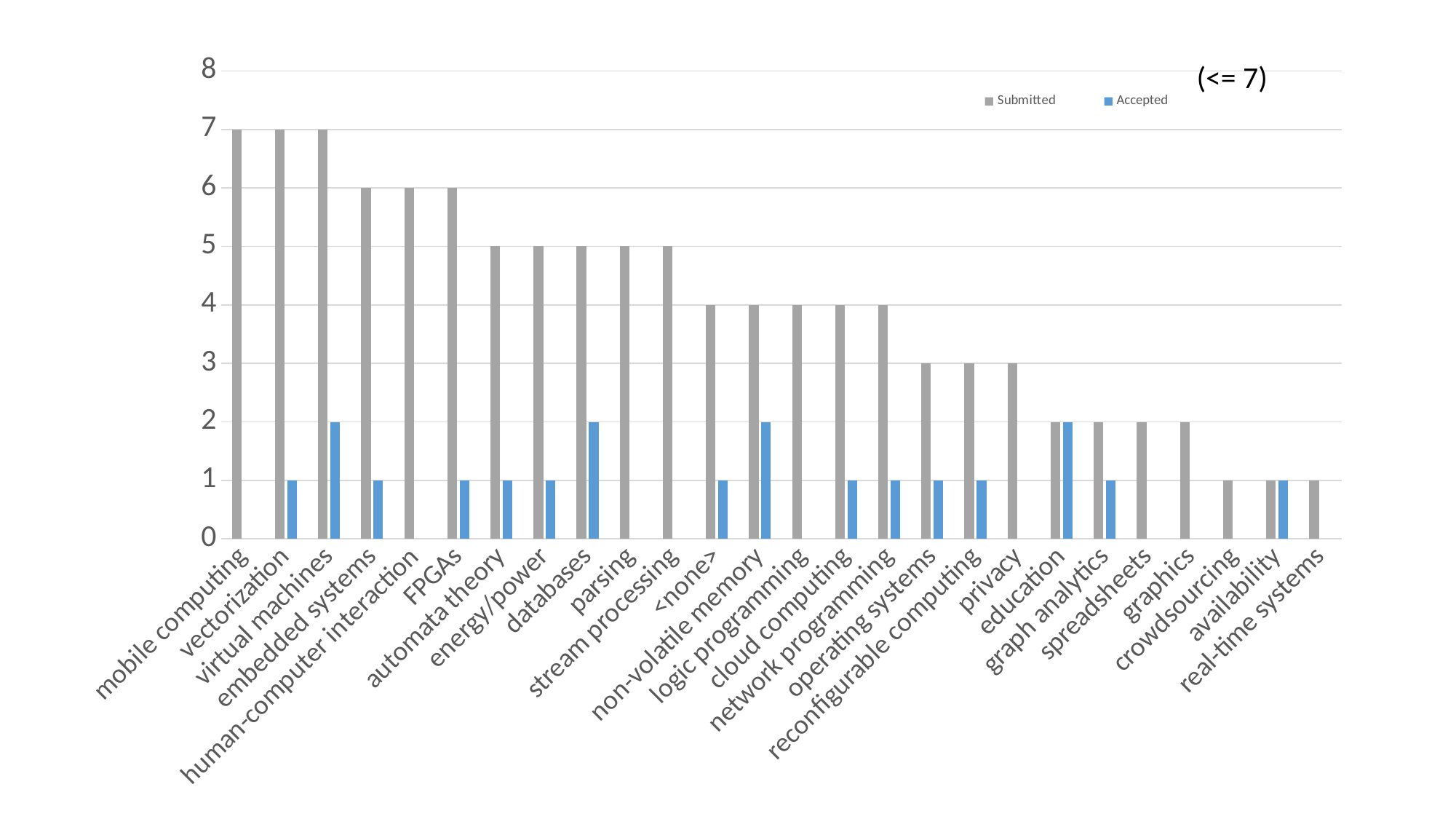
How many categories are shown on the x axis? 26 What are the two series named in the legend? Submitted and Accepted Is the Submitted value for mobile computing greater or less than 4? greater What is the Submitted value for embedded systems? 6 What is the difference between the Submitted and Accepted values for non-volatile memory? 2 What is the Accepted value for virtual machines? 2 How many series does the legend list? 2 What is the Accepted value for education? 2 Which has a higher Submitted value, privacy or parsing? parsing What is the Submitted value for databases? 5 Do the Submitted values generally rise or fall from left to right along the x axis? fall What type of chart is shown on the slide? bar chart